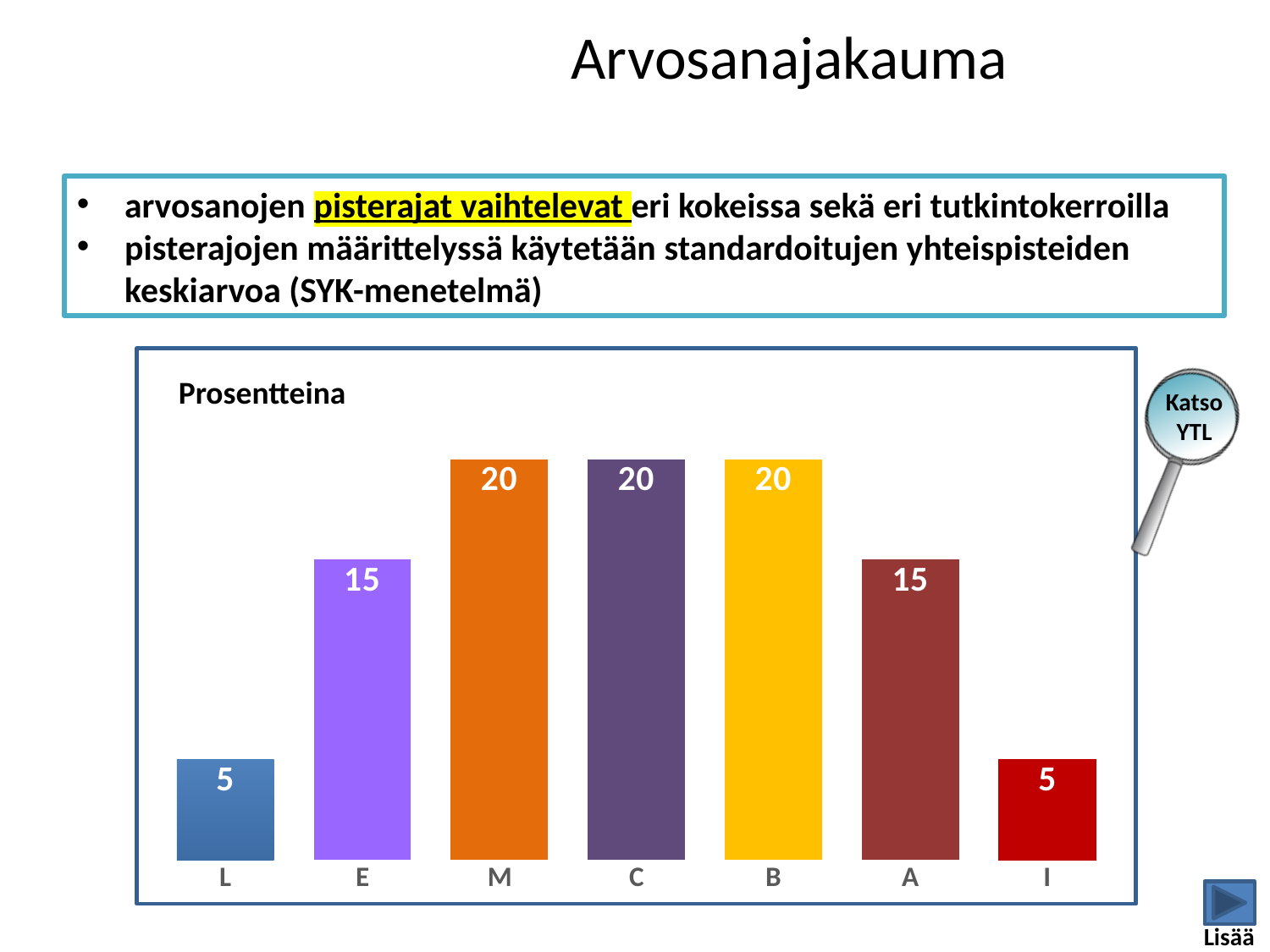
What is the value for category E? 15 What is the difference between the values for M and L? 15 How many categories are shown on the x axis? 7 What kind of chart is shown on the slide? bar chart What is the value for category M? 20 What label appears in the top-left corner of the chart area? Prosentteina What is the value for category A? 15 What is the difference between the values for E and I? 10 What is the value for category I? 5 Which is larger, the value for L or the value for E? E Which is larger, the value for C or the value for A? C What is the total of the values for L, E and M? 40